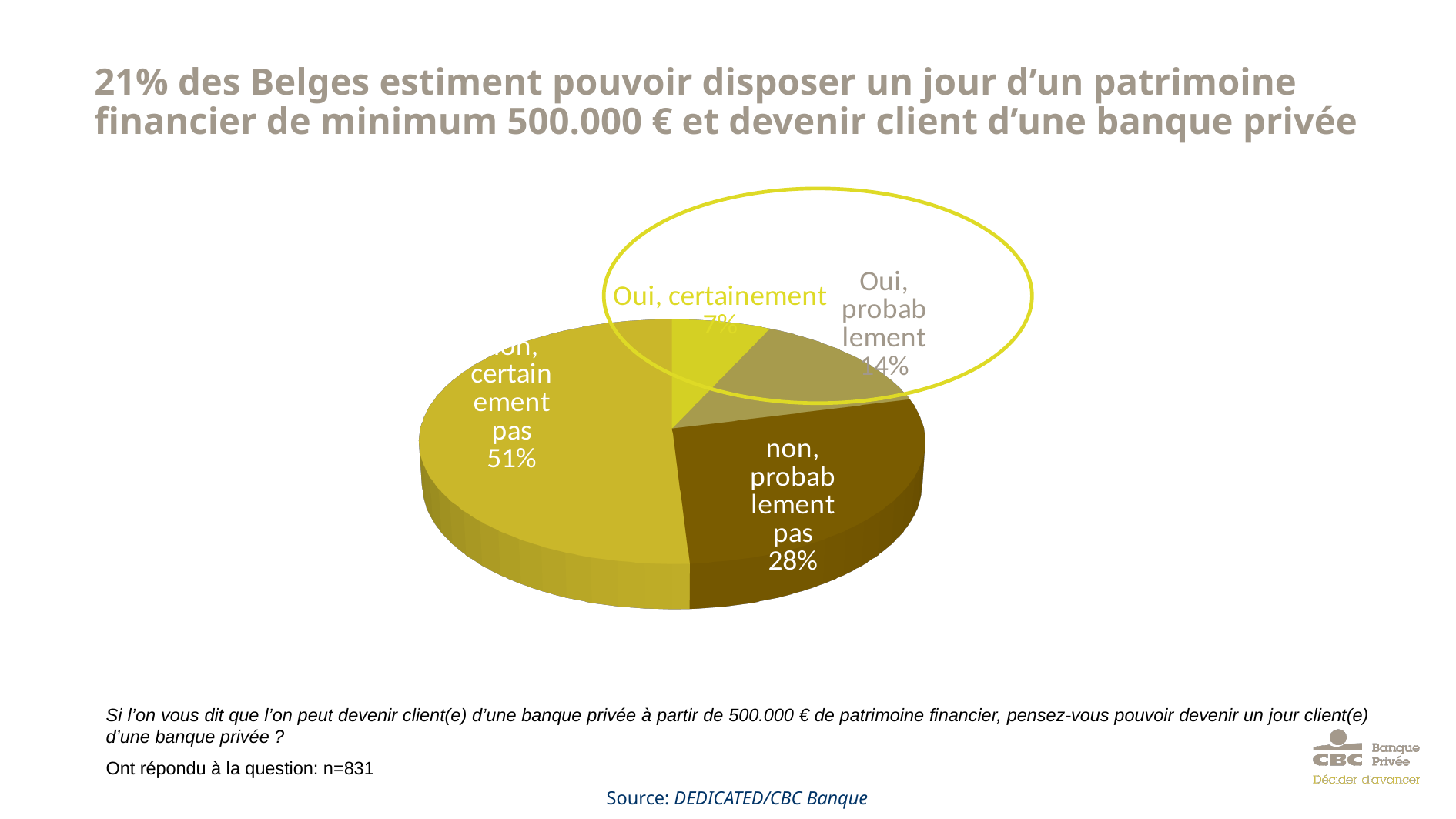
How many slices does the pie chart have? 4 Which is larger: the share for "Oui, probablement" or the share for "non, probablement pas"? non, probablement pas What share of respondents answered "non, certainement pas"? 51% What is the difference in percentage points between "non, certainement pas" and "non, probablement pas"? 23 What share of respondents answered "Oui, probablement"? 14% Which answer has the largest slice of the pie? non, certainement pas What is the combined share of the two "Oui" answers ("Oui, certainement" and "Oui, probablement")? 21% Which answer has the smallest slice of the pie? Oui, certainement What kind of chart is shown on the slide? pie chart What share of respondents answered "non, probablement pas"? 28% How many respondents answered the question, according to the note below the chart? n=831 What share of respondents answered "Oui, certainement"? 7%